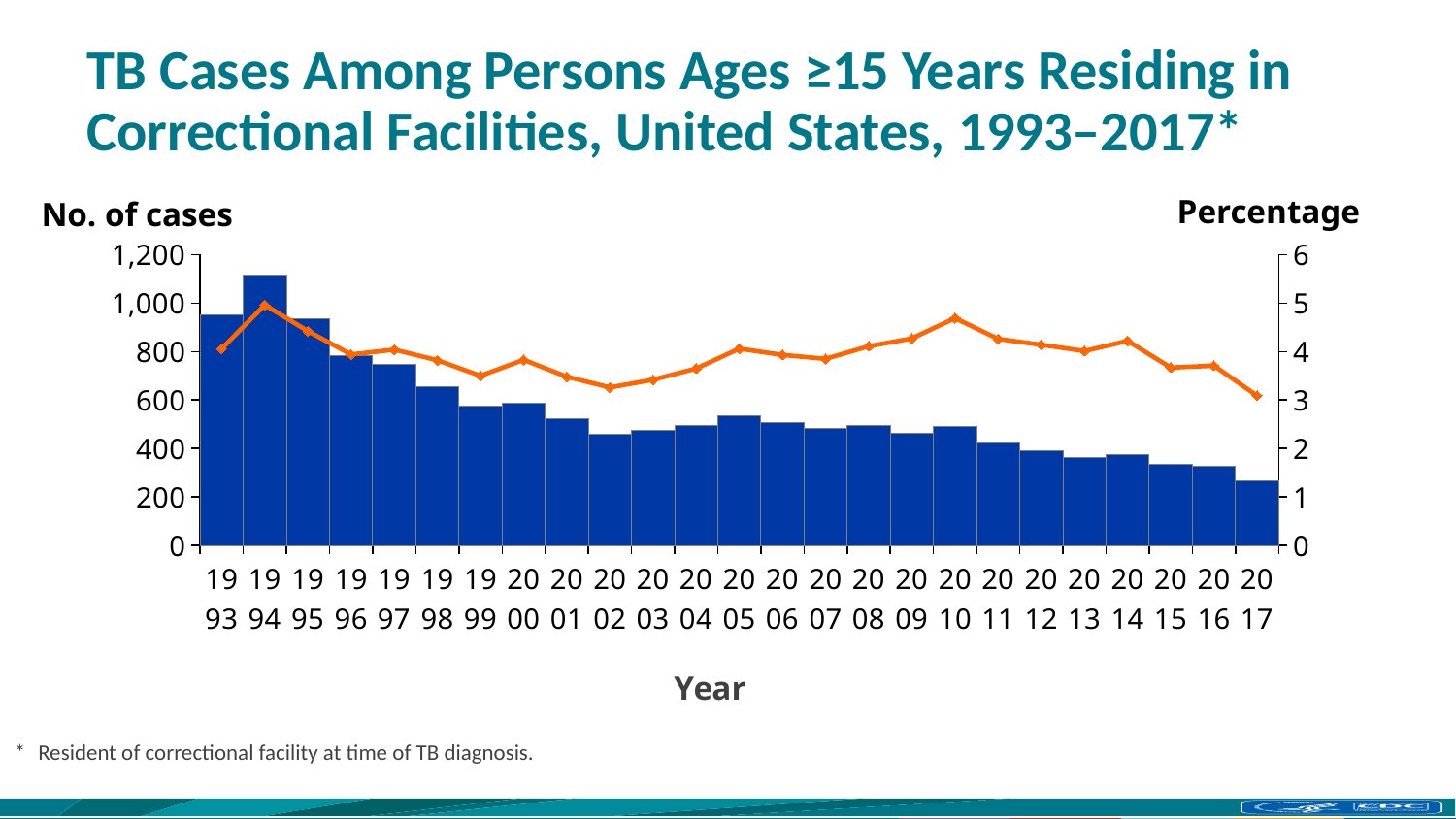
Is the number of cases in 1994 greater or less than 1,000? greater Is the number of cases in 2002 greater or less than 600? less Is the number of cases in 2017 greater or less than 400? less What kinds of chart are combined on this slide? A bar chart and a line chart Does the number of cases generally rise or fall from 1994 to 2017? Fall In which year does the percentage line reach its highest point? 1994 Which year has the lowest number of TB cases (shortest bar)? 2017 What is the label of the right-hand vertical axis? Percentage Which year has the highest number of TB cases (tallest bar)? 1994 How many years are shown on the x axis of the chart? 25